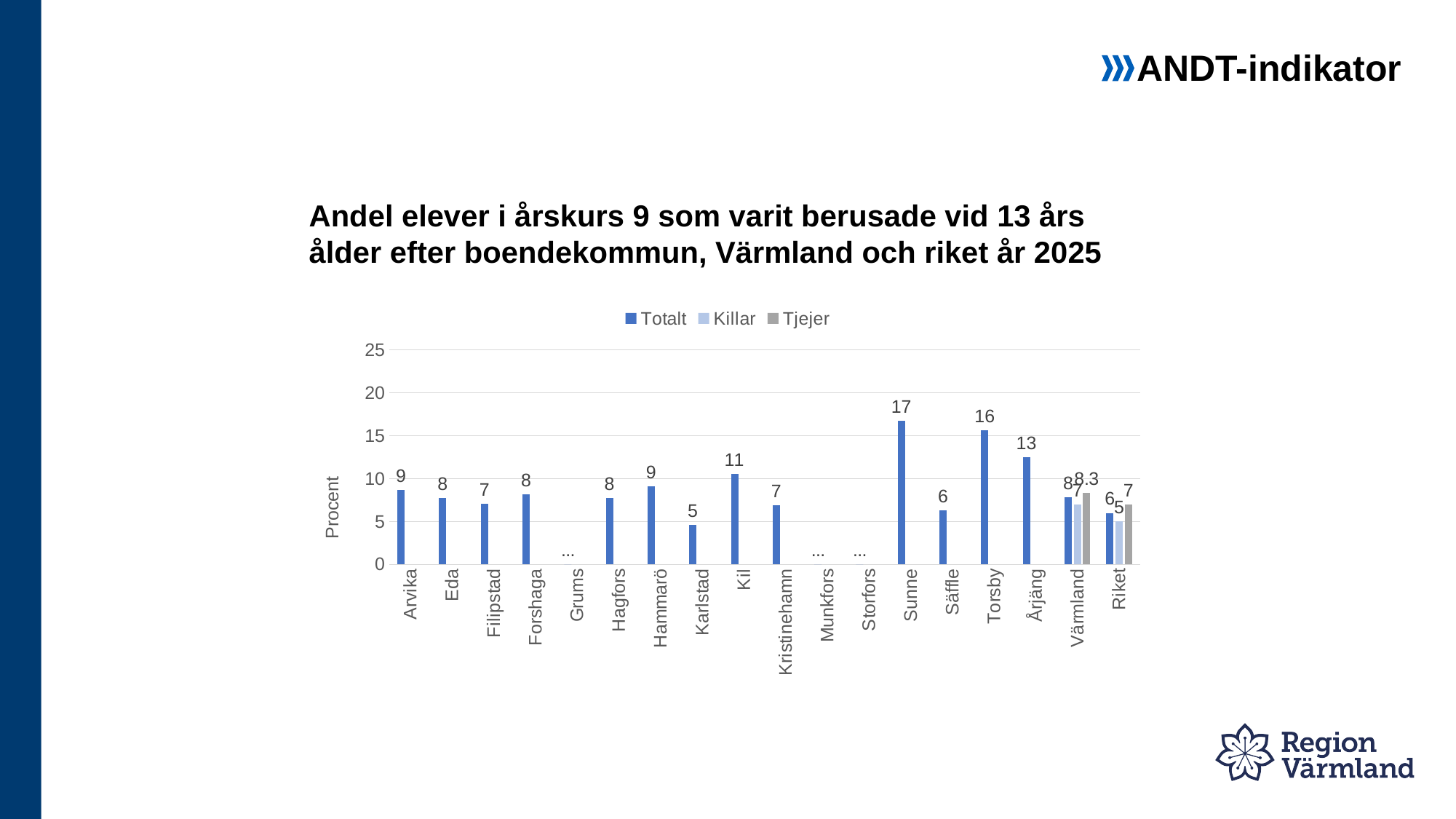
What is the Killar value for Riket? 5 Which has a larger Totalt value, Årjäng or Kil? Årjäng What is the label on the y axis? Procent What is the difference between the Totalt values for Sunne and Torsby? 1 What is the Totalt value for Kil? 11 Which municipality has the highest Totalt value? Sunne What is the Totalt value for Sunne? 17 How many categories are shown on the x axis? 18 Which municipality has the lowest Totalt value among those with a plotted bar? Karlstad What is the Tjejer value for Värmland? 8.3 What kind of chart is shown on the slide? bar chart How many series does the legend list? 3